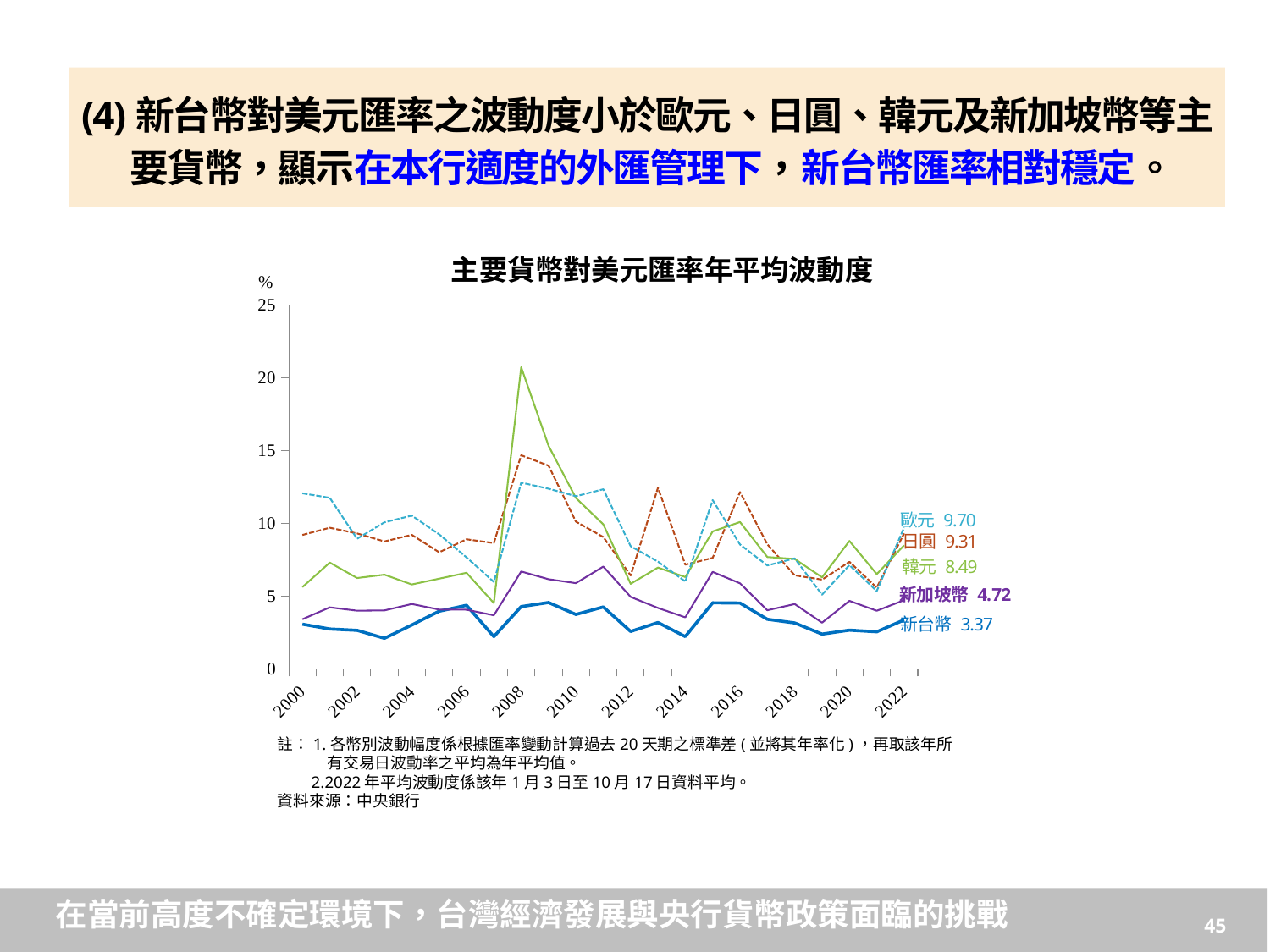
Which currency has the highest 2022 value labelled in the chart? 歐元 What is the difference between the 2022 values of 歐元 and 新台幣? 6.33 Which has a larger 2022 value, 日圓 or 韓元? 日圓 What is the title of the chart? 主要貨幣對美元匯率年平均波動度 How many currency series are plotted in the chart? 5 Is the peak value of 韓元 around 2009 greater or less than 20? greater What is the 2022 value shown for 歐元 in the chart? 9.70 Which currency has the lowest 2022 value labelled in the chart? 新台幣 What is the 2022 value shown for 新加坡幣 in the chart? 4.72 What is the 2022 value shown for 韓元 in the chart? 8.49 What type of chart is shown on the slide? Line chart What is the 2022 value shown for 新台幣 in the chart? 3.37